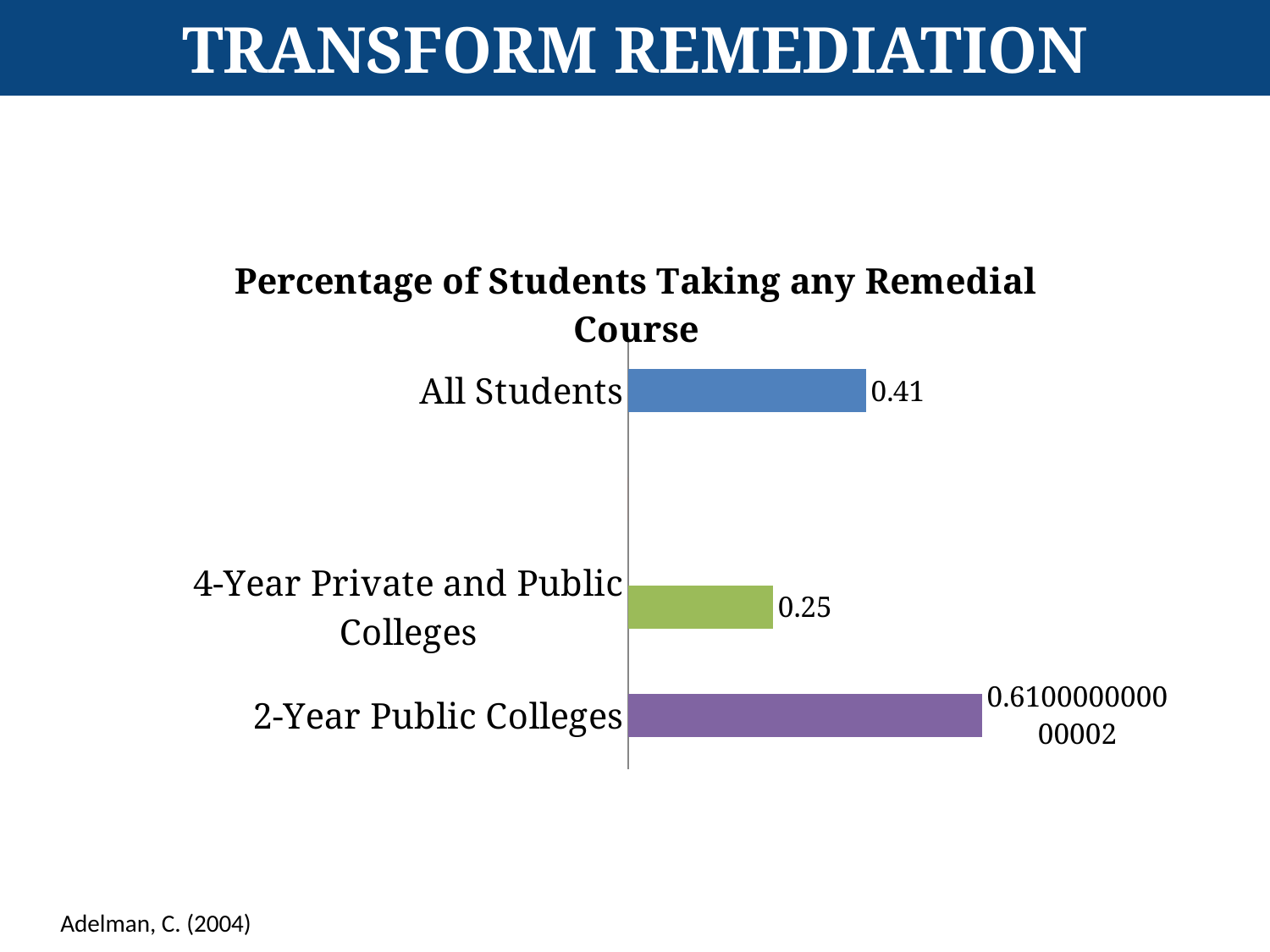
What is the difference between the values for All Students and 4-Year Private and Public Colleges? 0.16 What is the value for All Students? 0.41 What is the value for 4-Year Private and Public Colleges? 0.25 Which category has the highest value? 2-Year Public Colleges What is the title of the chart? Percentage of Students Taking any Remedial Course How many categories are shown in the chart? 3 What kind of chart is shown on the slide? Bar chart What is the value printed next to the bar for 2-Year Public Colleges? 0.610000000000002 Which is larger, the value for 2-Year Public Colleges or the value for All Students? 2-Year Public Colleges Which category has the lowest value? 4-Year Private and Public Colleges What colour is the bar for 2-Year Public Colleges? Purple Which is larger, the value for All Students or the value for 4-Year Private and Public Colleges? All Students